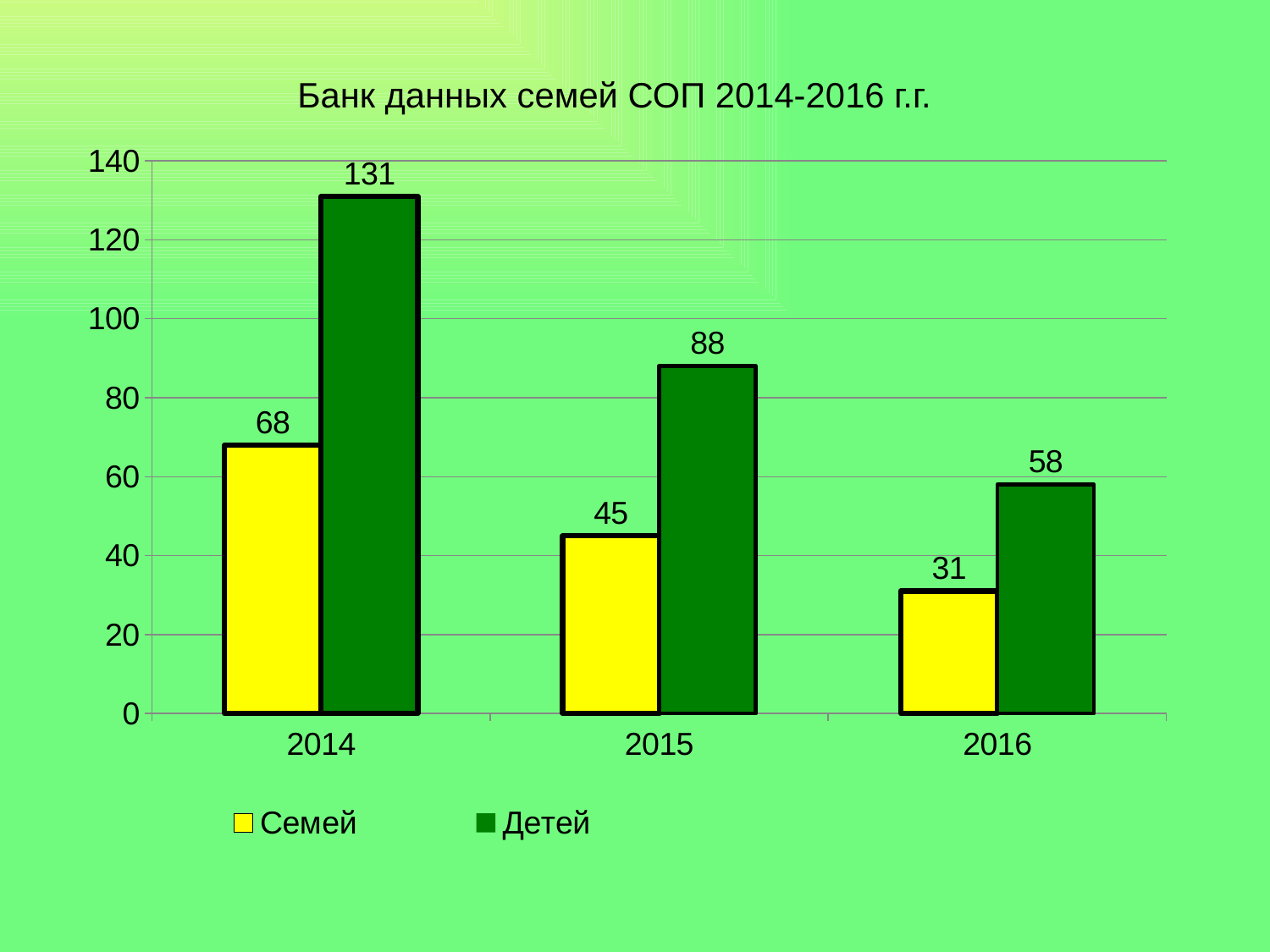
What is the value for Детей in 2015? 88 What is the value for Семей in 2014? 68 What is the value for Семей in 2016? 31 In which year is the value for Семей lowest? 2016 What is the difference between the Детей values for 2015 and 2016? 30 How many series does the legend list? 2 How many years are shown on the x axis? 3 What kind of chart is shown on the slide? bar chart Which is larger in 2015: Семей or Детей? Детей In which year is the value for Детей highest? 2014 Do the values for Семей rise or fall from 2014 to 2016? fall What is the difference between Детей and Семей in 2014? 63